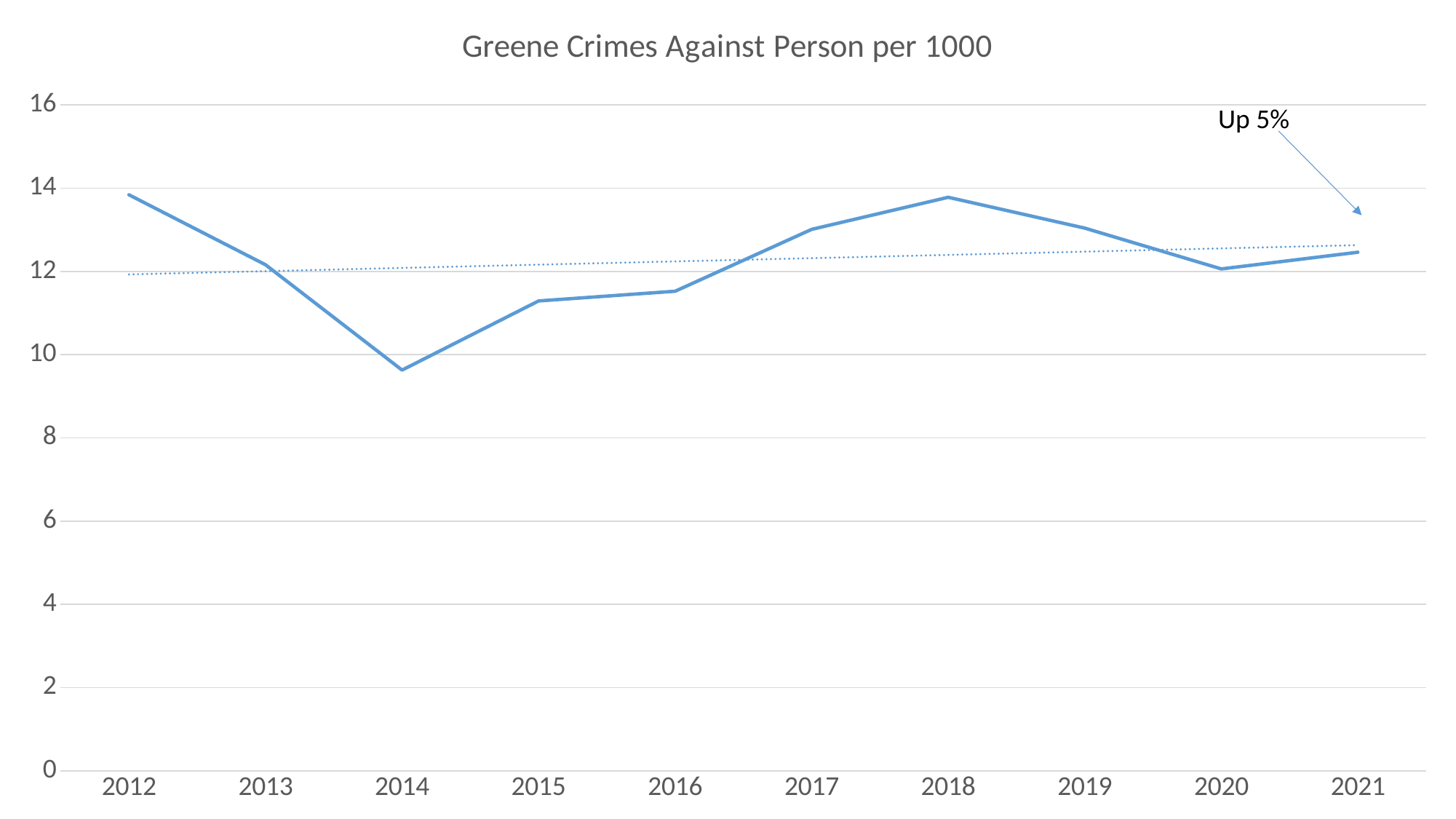
Is the value for 2016 greater or less than 12? less Do the values rise or fall from 2014 to 2018? rise Which year has the lowest value? 2014 Is the value for 2012 greater or less than 12? greater Is the value for 2014 greater or less than 10? less What is the title of the chart? Greene Crimes Against Person per 1000 Which is larger, the value for 2014 or the value for 2018? 2018 What does the annotation near the 2021 end of the line say? Up 5% How many years are plotted along the x axis? 10 Which is larger, the value for 2013 or the value for 2014? 2013 What kind of chart is shown on the slide? line chart